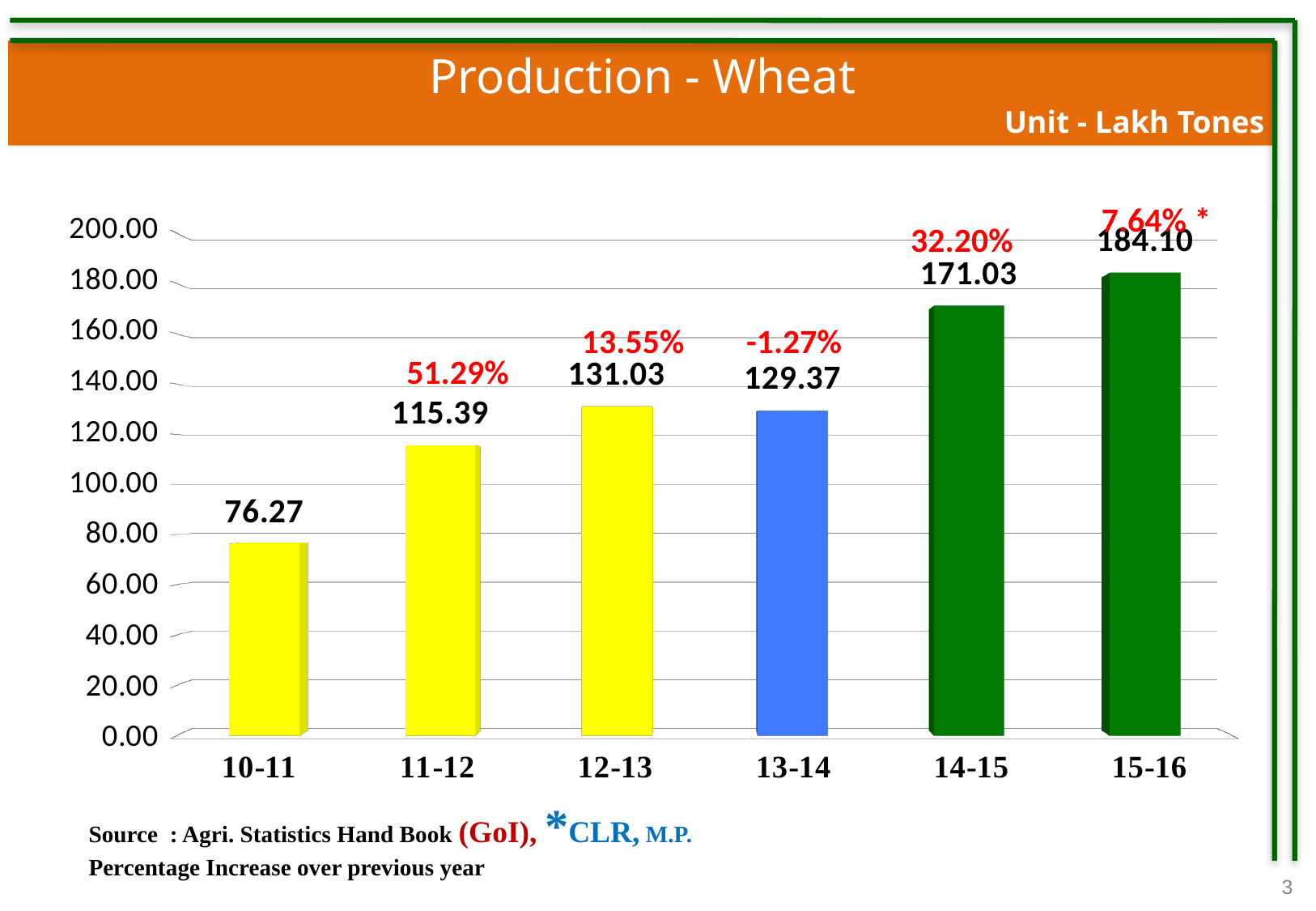
Which year has the lowest wheat production? 10-11 What unit is stated for the chart values? Lakh Tones Is the value for 11-12 greater or less than 100.00? greater What kind of chart is shown on the slide? bar chart Which year shows a negative percentage change over the previous year? 13-14 Which is larger, the wheat production in 12-13 or in 13-14? 12-13 How many years are shown on the x axis? 6 What percentage increase over the previous year is shown for 14-15? 32.20% What is the wheat production value for 13-14? 129.37 What is the wheat production value for 10-11? 76.27 What is the difference in wheat production between 15-16 and 14-15? 13.07 Which year has the highest wheat production? 15-16